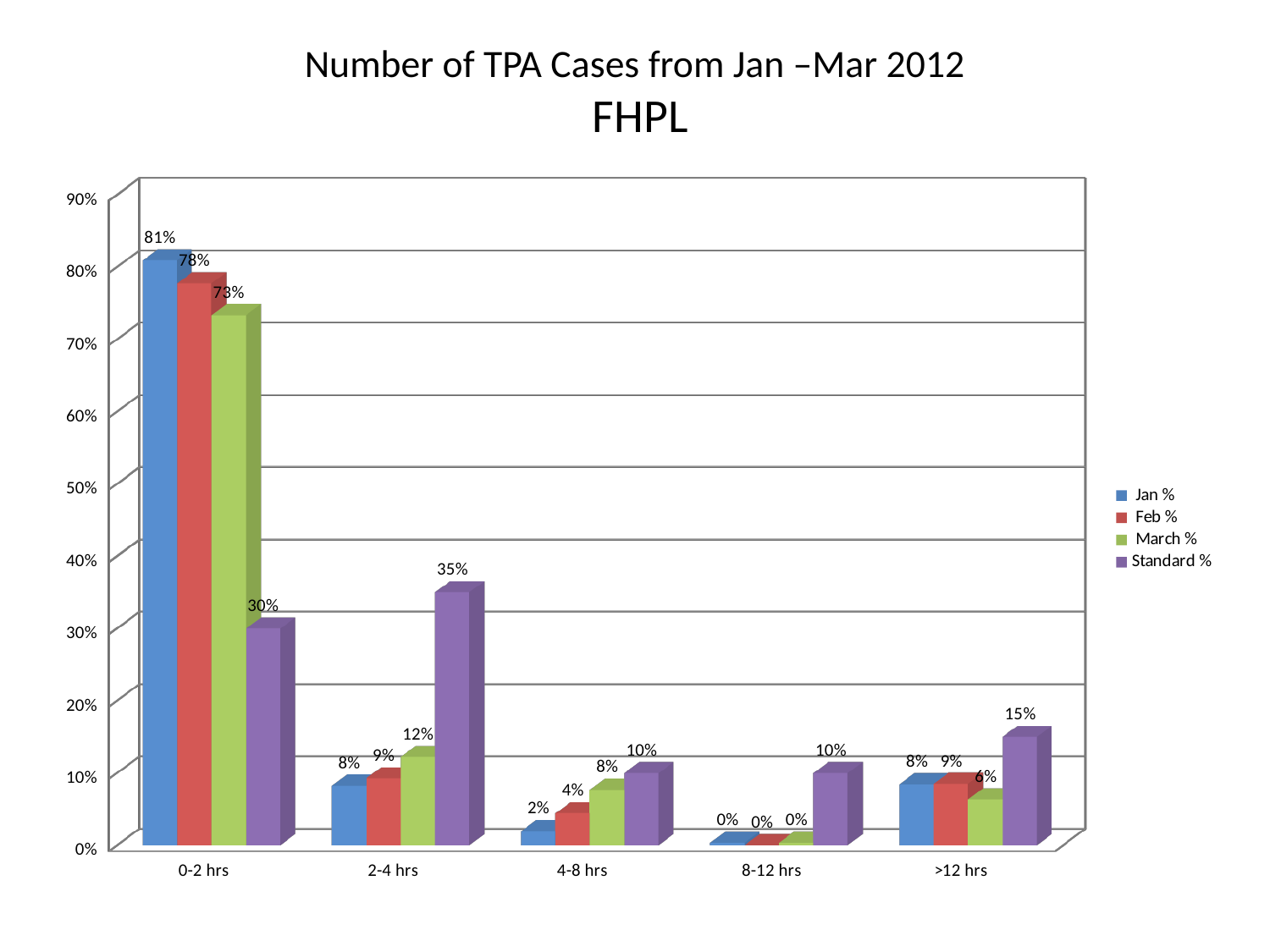
Which category has the lowest Standard % value? 4-8 hrs and 8-12 hrs (both 10%) What kind of chart is shown on the slide? Bar chart What is the difference between the Jan % and Standard % values for the 0-2 hrs category? 51% Which colour represents the Standard % series? Purple What is the March % value for the >12 hrs category? 6% How many series does the legend list? 4 What is the Jan % value for the 0-2 hrs category? 81% What is the Feb % value for the 4-8 hrs category? 4% What is the Standard % value for the 2-4 hrs category? 35% Which is larger for the 2-4 hrs category, the March % value or the Standard % value? Standard % How many time categories are shown on the x axis? 5 Which category has the highest Jan % value? 0-2 hrs